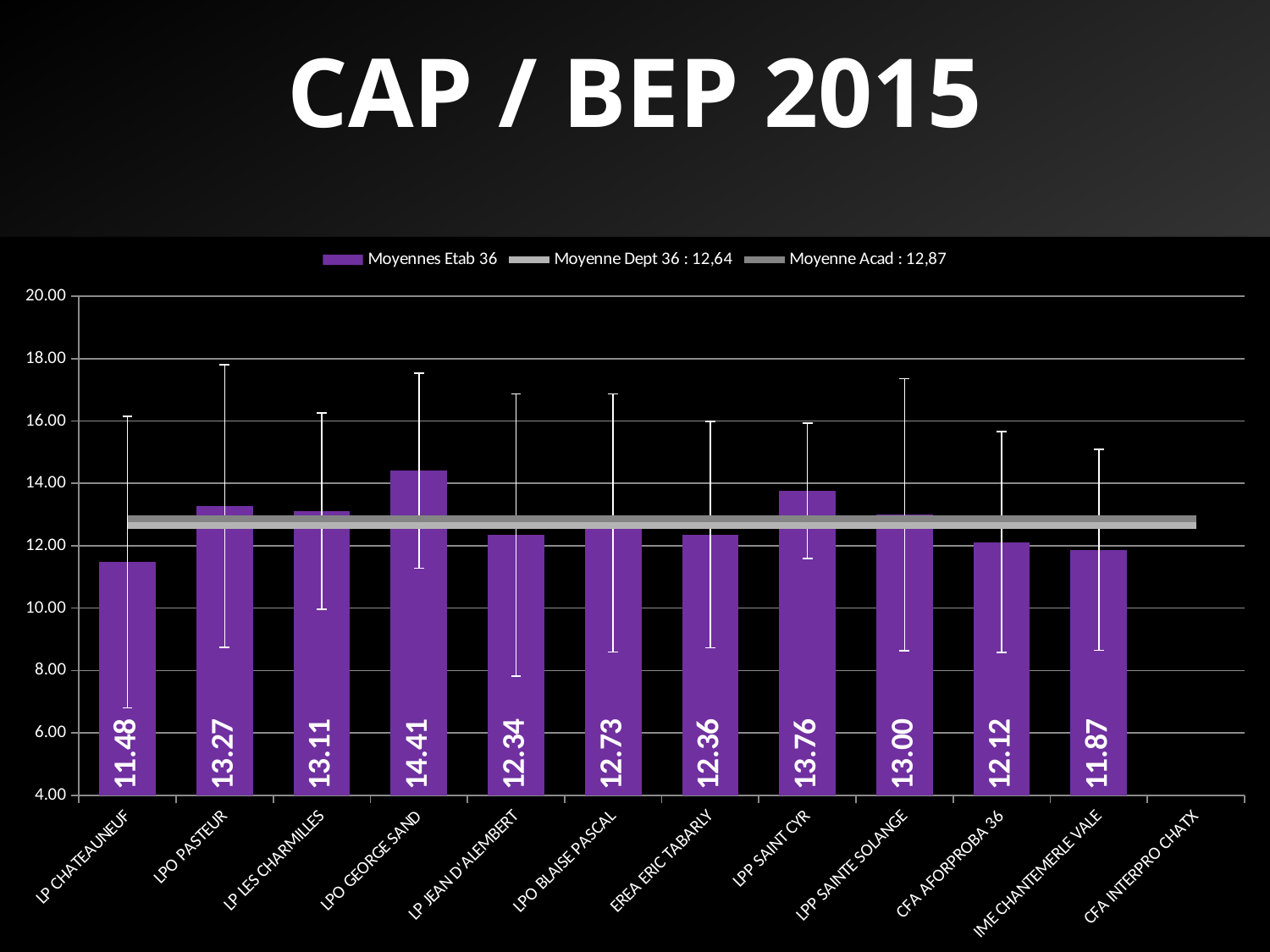
What is the value for LP CHATEAUNEUF? 11.48 What kind of chart is shown on the slide? bar chart What value does the legend give for Moyenne Acad? 12,87 Which establishment has the lowest labelled value? LP CHATEAUNEUF How many series does the legend list? 3 What is the value for LPP SAINT CYR? 13.76 What is the difference between the values for LPO GEORGE SAND and LP CHATEAUNEUF? 2.93 Which is larger, the value for LPO PASTEUR or the value for LP LES CHARMILLES? LPO PASTEUR What is the value for LPO GEORGE SAND? 14.41 Is the value for CFA AFORPROBA 36 greater or less than 14.00? less Which establishment has the highest value? LPO GEORGE SAND What is the value for IME CHANTEMERLE VALE? 11.87